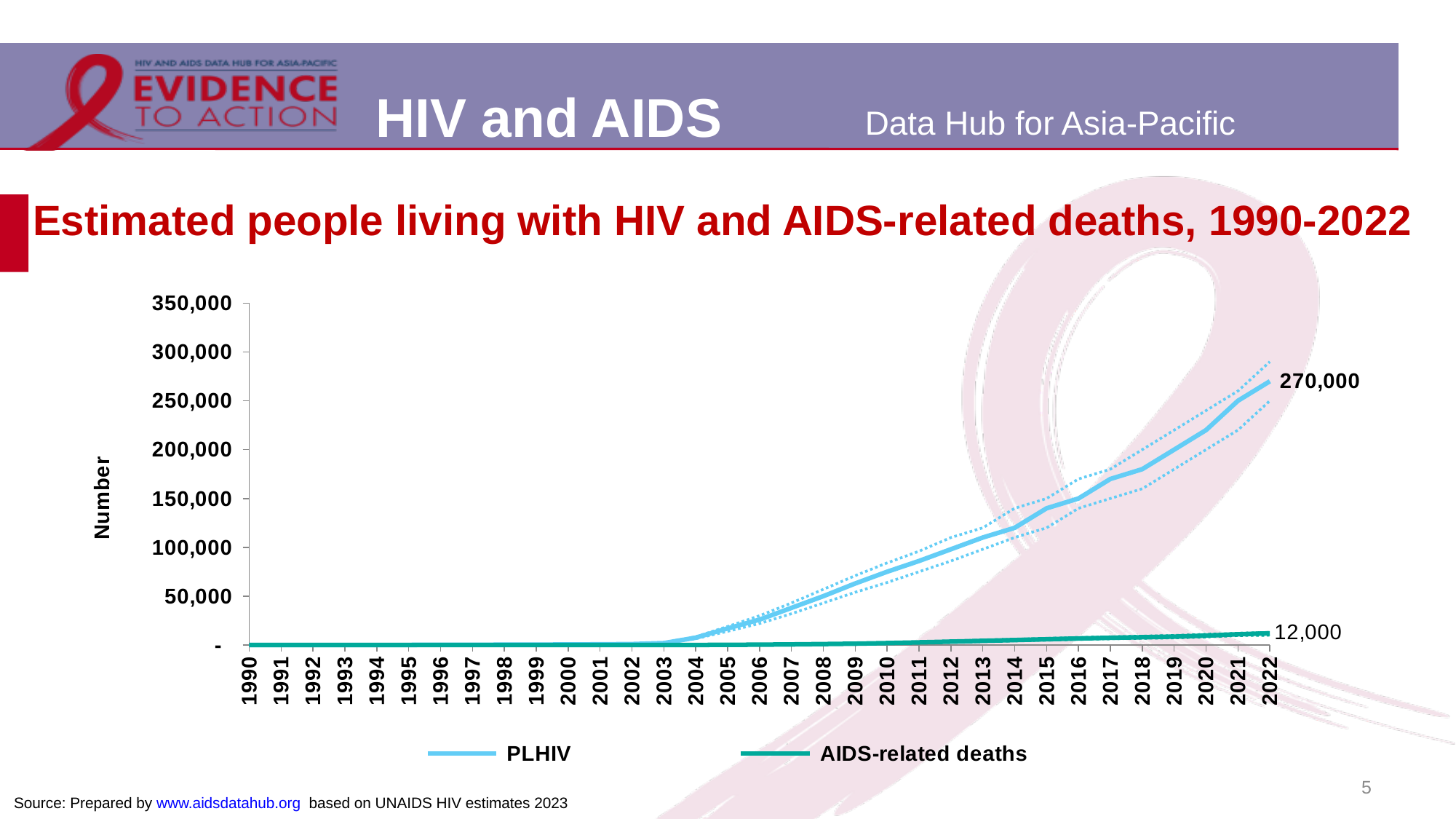
How many series does the legend list? 2 What is the difference between the PLHIV value and the AIDS-related deaths value in 2022? 258,000 What is the number of AIDS-related deaths in 2022? 12,000 Does the PLHIV series rise or fall from 2003 to 2022? rise What kind of chart is shown on the slide? line chart How many years are shown on the x axis of the chart? 33 What is the estimated number of people living with HIV (PLHIV) in 2022? 270,000 What is the label on the y axis of the chart? Number Is the PLHIV value for 2016 greater or less than 100,000? greater Is the PLHIV value for 2020 greater or less than 200,000? greater In 2022, which series has the larger value, PLHIV or AIDS-related deaths? PLHIV Is the PLHIV value for 2010 greater or less than 100,000? less